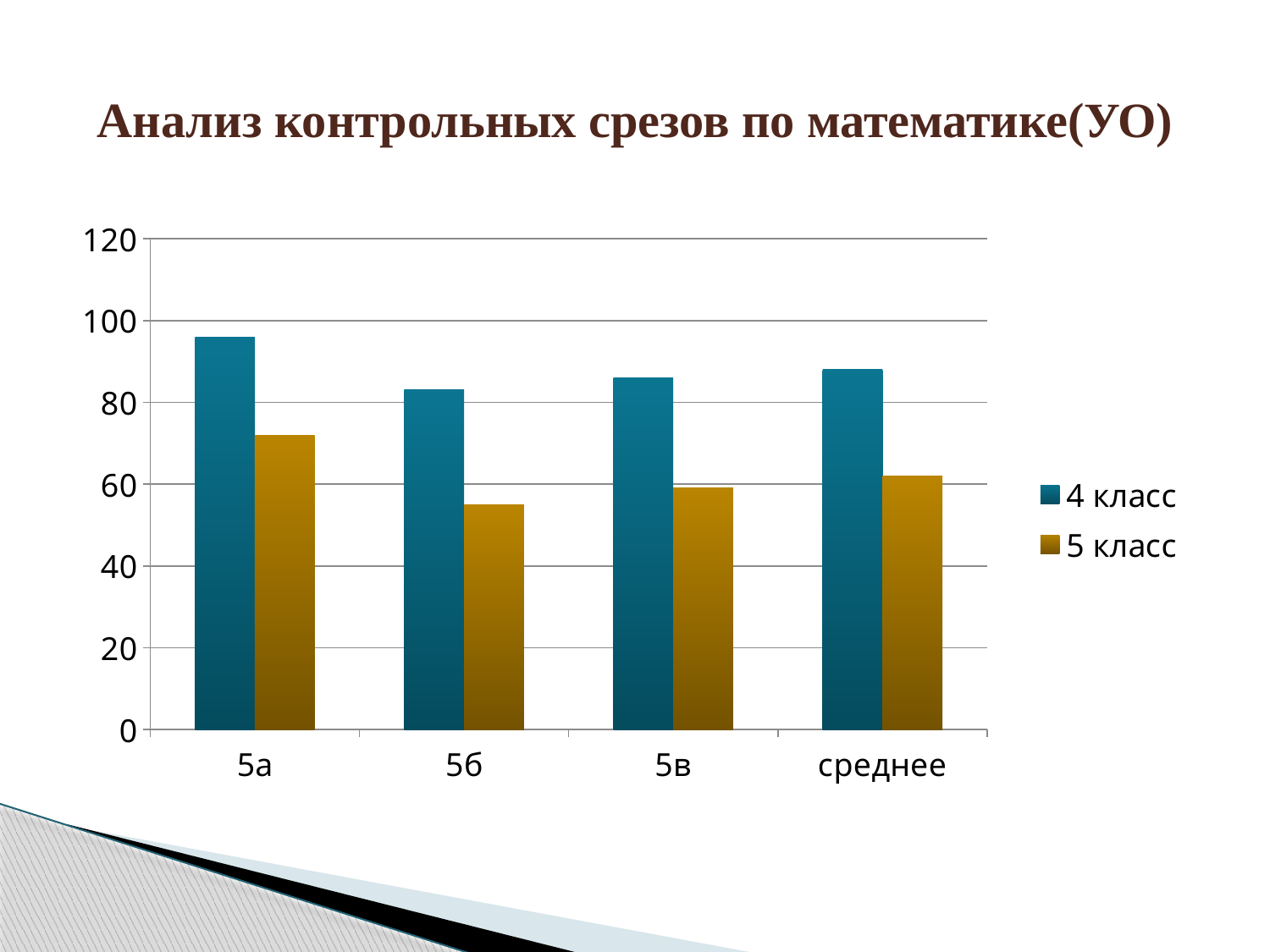
For the 4 класс series, which is larger: the value for 5а or the value for среднее? 5а Is the value for 5б in the 5 класс series greater or less than 60? less Which category has the highest value for the 5 класс series? 5а What kind of chart is shown on the slide? bar chart How many categories are shown on the x axis? 4 What is the title of the slide? Анализ контрольных срезов по математике(УО) For the category 5б, which series has the larger value, 4 класс or 5 класс? 4 класс Which category has the highest value for the 4 класс series? 5а Is the value for среднее in the 4 класс series greater or less than 80? greater How many series does the legend list? 2 Is the value for 5а in the 4 класс series greater or less than 80? greater For the 5 класс series, which is larger: the value for 5а or the value for 5в? 5а